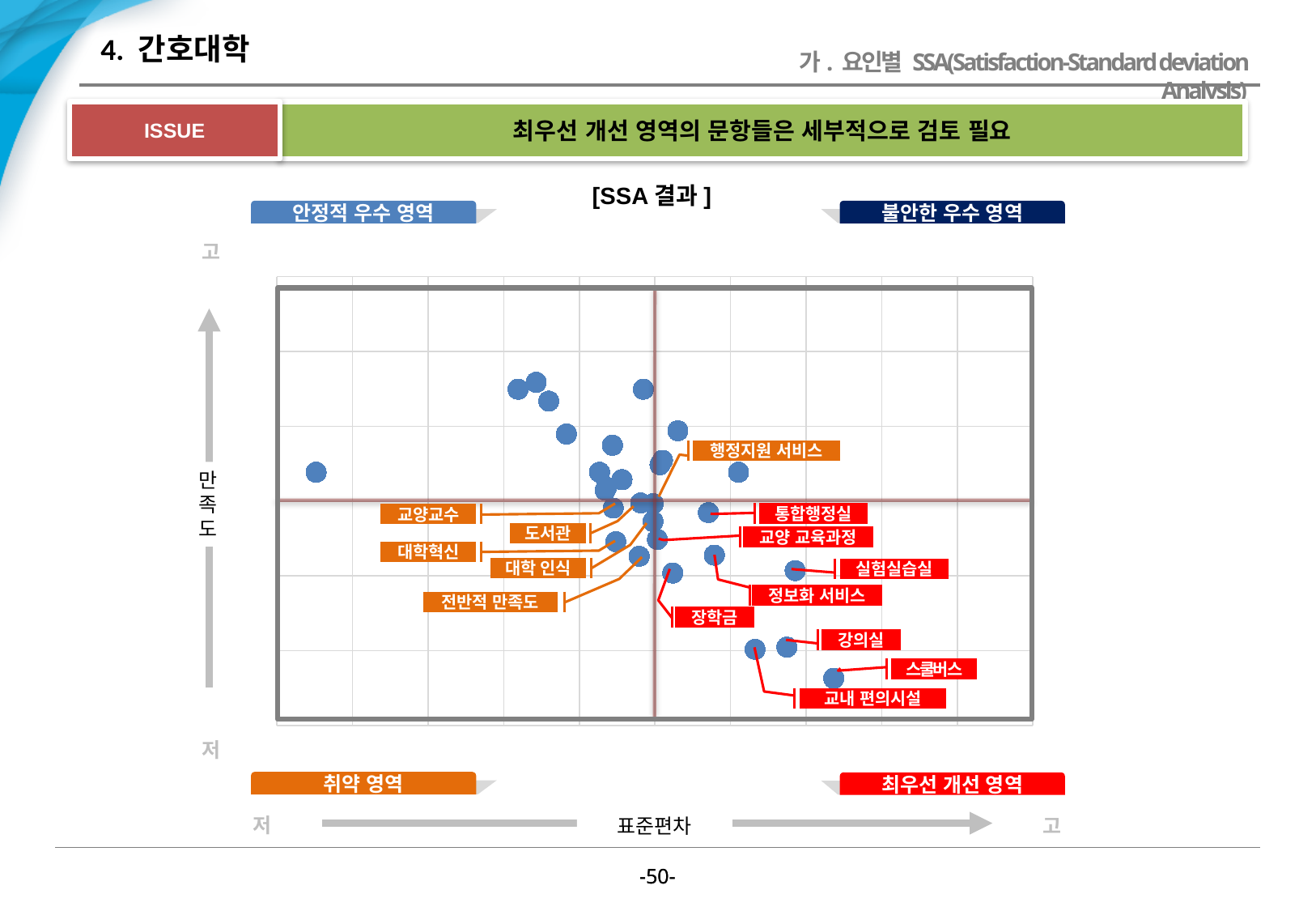
Which has the higher standard deviation (표준편차) value, 스쿨버스 or 강의실? 스쿨버스 Which has the higher satisfaction (만족도) value, 통합행정실 or 장학금? 통합행정실 Which has the lower standard deviation (표준편차) value, 전반적 만족도 or 실험실습실? 전반적 만족도 How many points are labeled with orange labels in the chart? 6 How many points are labeled with red labels in the chart? 8 Among the labeled points, which has the lowest satisfaction (만족도) value? 스쿨버스 What kind of chart is shown on the slide? scatter chart What is the title of the chart? [SSA 결과 ] Among the labeled points, which has the highest satisfaction (만족도) value? 행정지원 서비스 What label is shown on the horizontal axis of the chart? 표준편차